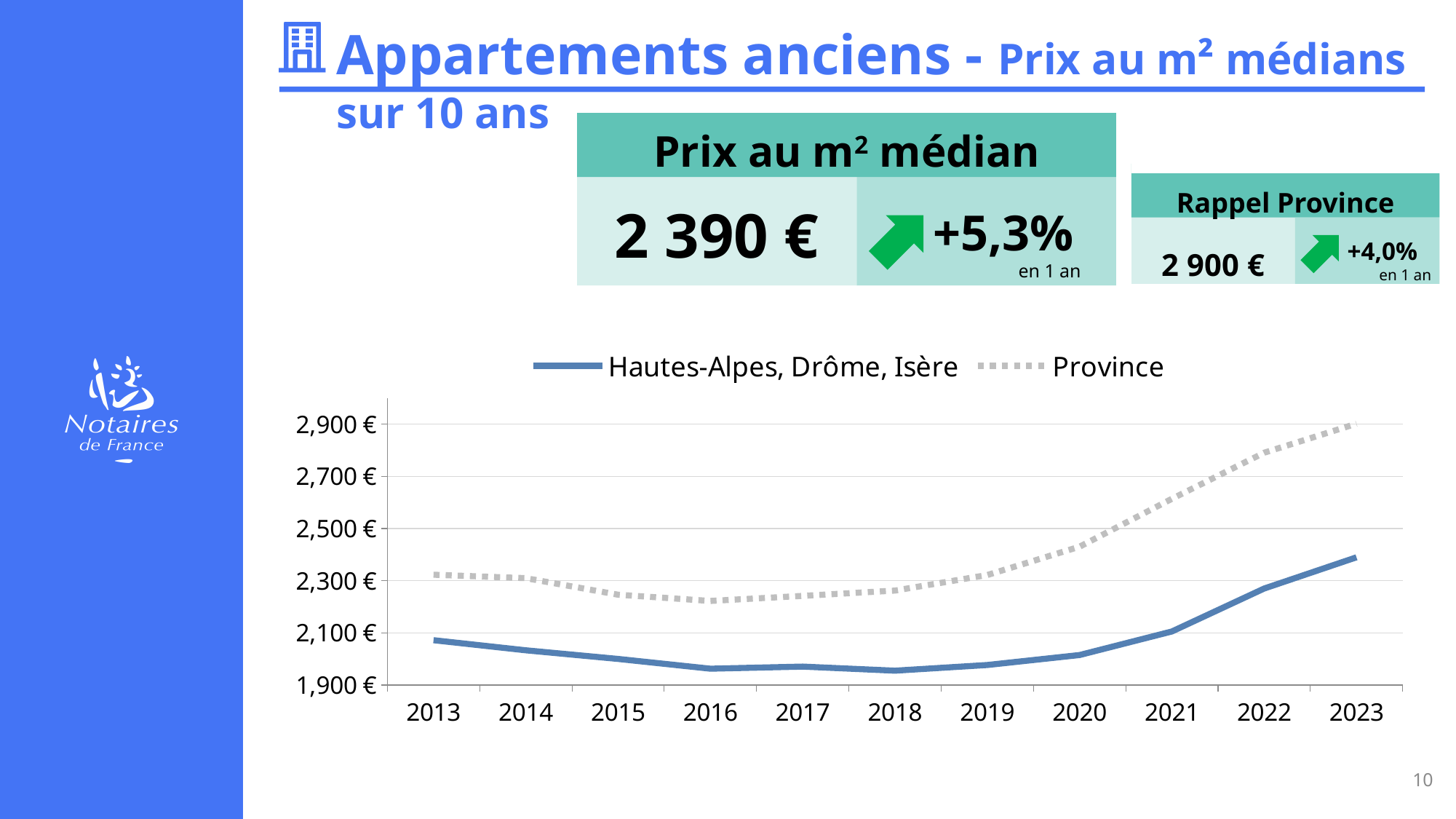
How many series does the chart legend list? 2 What are the names of the two series in the chart legend? Hautes-Alpes, Drôme, Isère and Province In 2023, which series has the higher value: Hautes-Alpes, Drôme, Isère or Province? Province What is the value of the Province series in 2023? 2,900 € In which year does the Province series reach its highest value? 2023 What kind of chart is shown on the slide? line chart Is the value for Hautes-Alpes, Drôme, Isère in 2016 greater or less than 2,100 €? less Is the value for Province in 2022 greater or less than 2,700 €? greater Is the value for Province in 2016 greater or less than 2,300 €? less In which year does the Hautes-Alpes, Drôme, Isère series reach its highest value? 2023 Between 2018 and 2023, does the Hautes-Alpes, Drôme, Isère series rise or fall? rise How many years are plotted along the x axis of the chart? 11